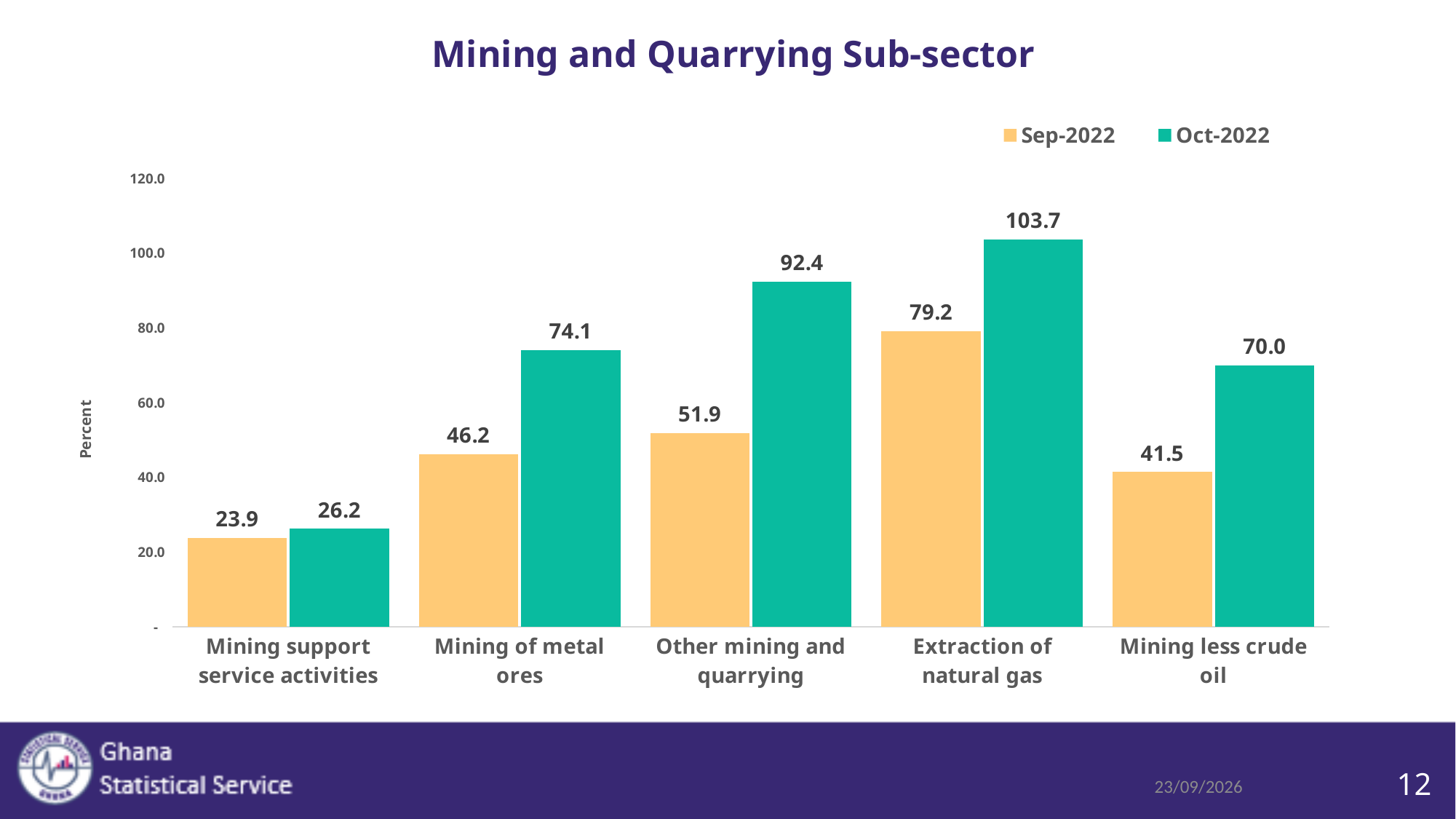
How many categories are shown on the x axis? 5 What is the difference between the Oct-2022 and Sep-2022 values for Mining of metal ores? 27.9 What is the difference between the Oct-2022 and Sep-2022 values for Other mining and quarrying? 40.5 What is the Sep-2022 value for Mining of metal ores? 46.2 How many series does the legend list? 2 What is the Oct-2022 value for Mining less crude oil? 70.0 Is the Oct-2022 value for Other mining and quarrying greater or less than 100.0? less Which category has the lowest Sep-2022 value? Mining support service activities What is the Oct-2022 value for Extraction of natural gas? 103.7 What kind of chart is shown on the slide? Bar chart Which category has the highest Oct-2022 value? Extraction of natural gas Which is larger: the Sep-2022 value for Extraction of natural gas or the Oct-2022 value for Mining of metal ores? Sep-2022 value for Extraction of natural gas